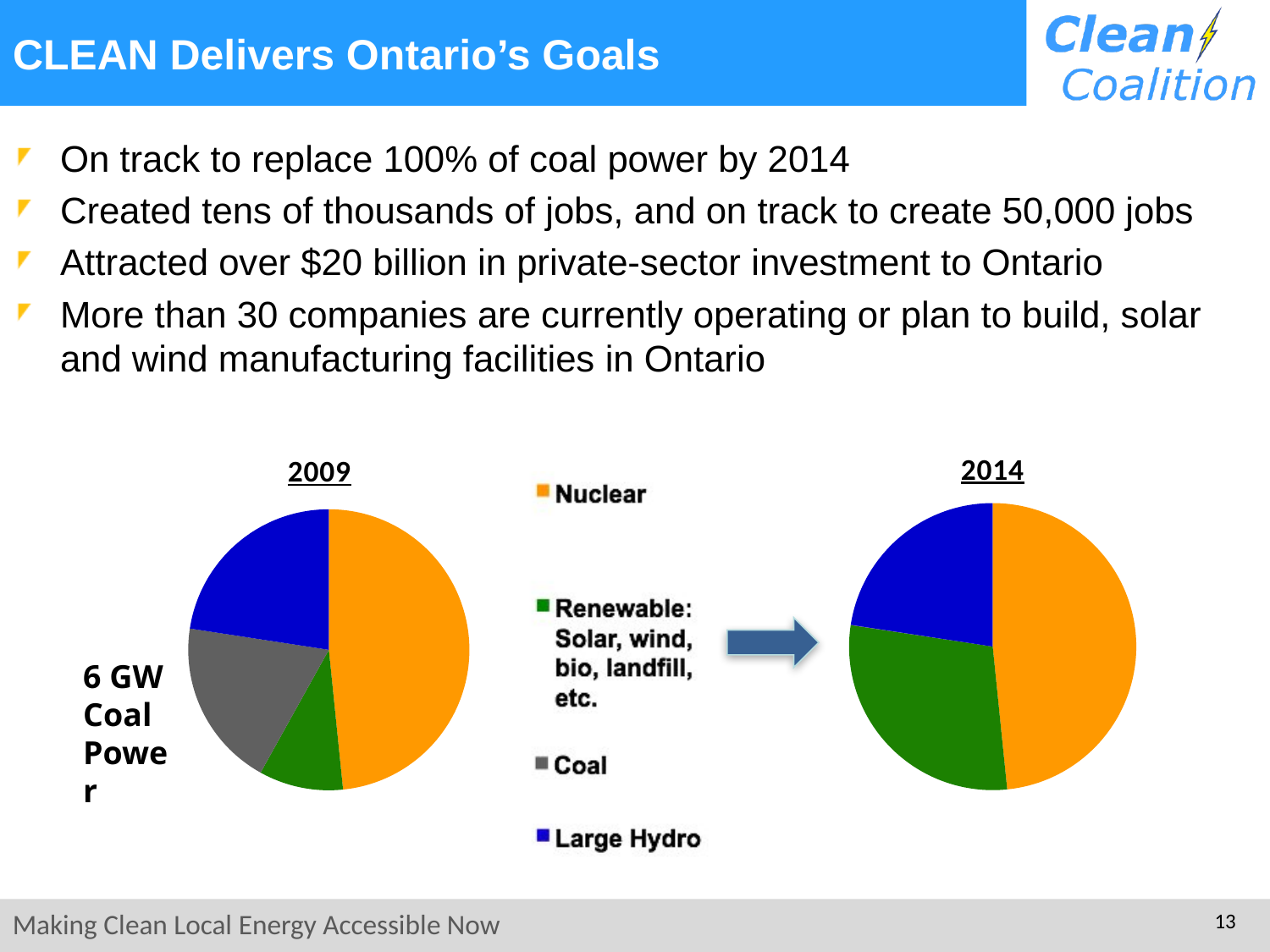
What kind of chart is the 2009 chart on the slide? pie chart In the 2014 pie chart, which energy source has the smallest slice? Large Hydro In the 2014 pie chart, which energy source has the largest slice? Nuclear In the 2009 pie chart, which energy source has the largest slice? Nuclear Which energy source appears in the 2009 pie chart but not in the 2014 pie chart? Coal How many slices does the 2014 pie chart have? 3 How many entries does the legend between the two pie charts list? 4 In the 2014 pie chart, which slice is larger: Renewable or Large Hydro? Renewable In the 2009 pie chart, which energy source has the smallest slice? Renewable What kind of chart is the 2014 chart on the slide? pie chart What colour represents Large Hydro in the pie charts? blue How many slices does the 2009 pie chart have? 4